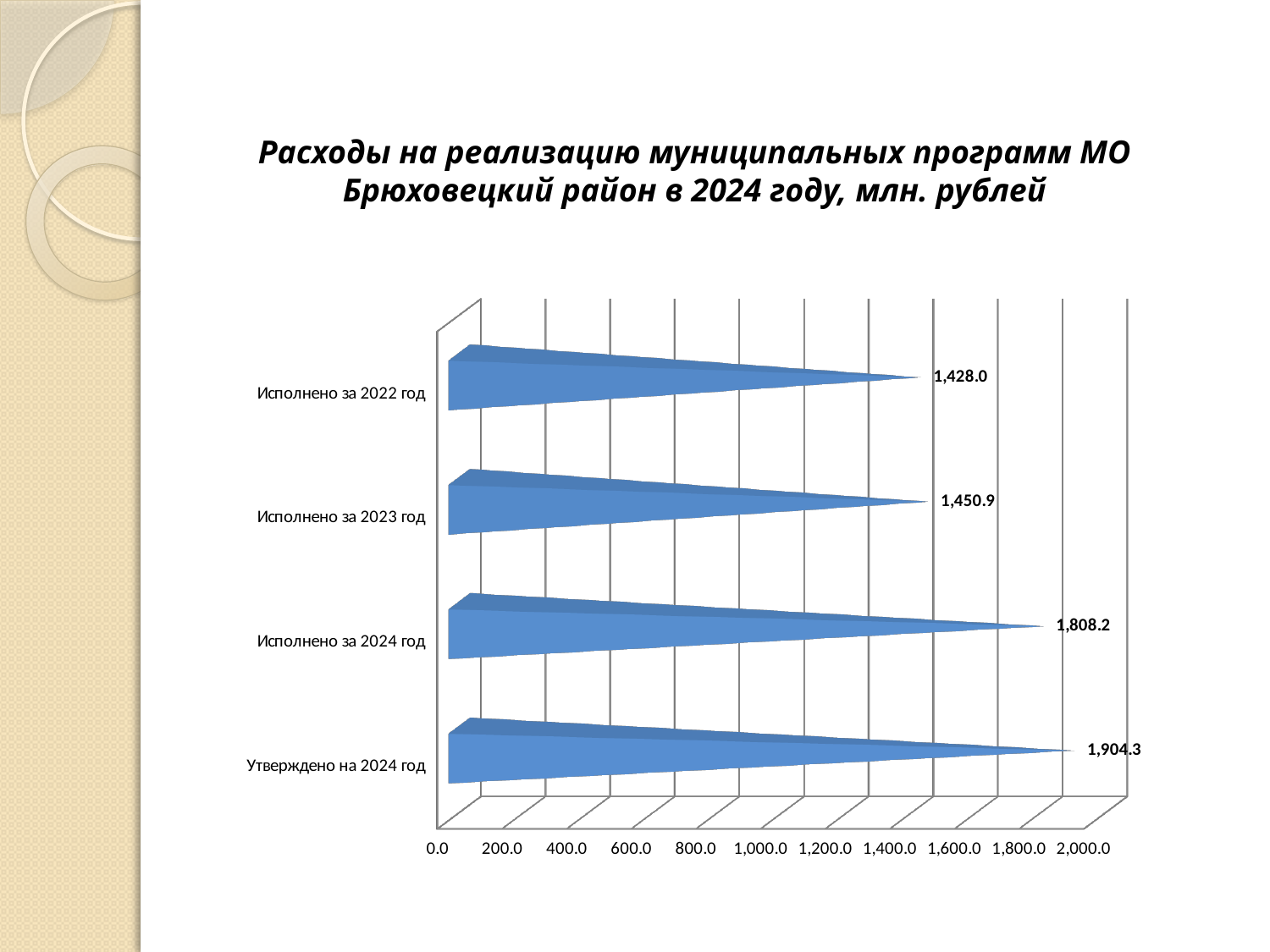
What kind of chart is shown on the slide? Bar chart How many categories are shown in the chart? 4 What is the value for «Исполнено за 2023 год»? 1,450.9 What is the difference between «Утверждено на 2024 год» and «Исполнено за 2024 год»? 96.1 Which category has the lowest value? Исполнено за 2022 год What unit of measurement is stated in the chart title? млн. рублей What is the value for «Исполнено за 2022 год»? 1,428.0 Which is larger: the value for «Исполнено за 2023 год» or «Исполнено за 2024 год»? Исполнено за 2024 год What is the value for «Исполнено за 2024 год»? 1,808.2 Which category has the highest value? Утверждено на 2024 год What is the difference between «Исполнено за 2024 год» and «Исполнено за 2023 год»? 357.3 What is the value for «Утверждено на 2024 год»? 1,904.3